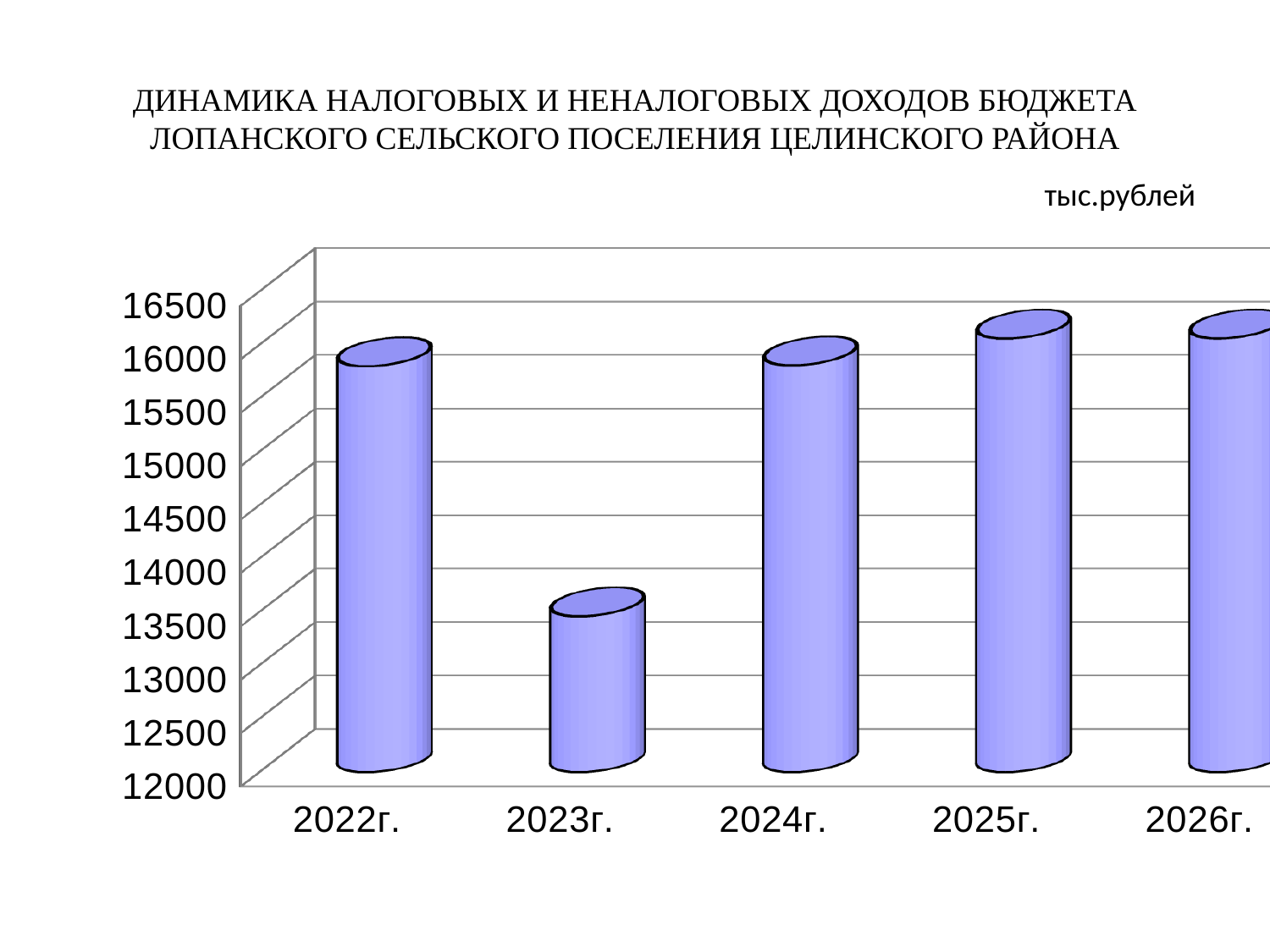
In what units are the values on the chart expressed, according to the label above the chart? тыс.рублей Is the value for 2024г. greater or less than 15500? greater Is the value for 2023г. greater or less than 13000? greater Which is larger, the value for 2023г. or the value for 2025г.? 2025г. Is the value for 2023г. greater or less than 14000? less Which is larger, the value for 2022г. or the value for 2023г.? 2022г. Which year has the lowest value in the chart? 2023г. What is the lowest value shown on the vertical axis of the chart? 12000 How many years are shown on the x axis of the chart? 5 What kind of chart is shown on the slide? bar chart